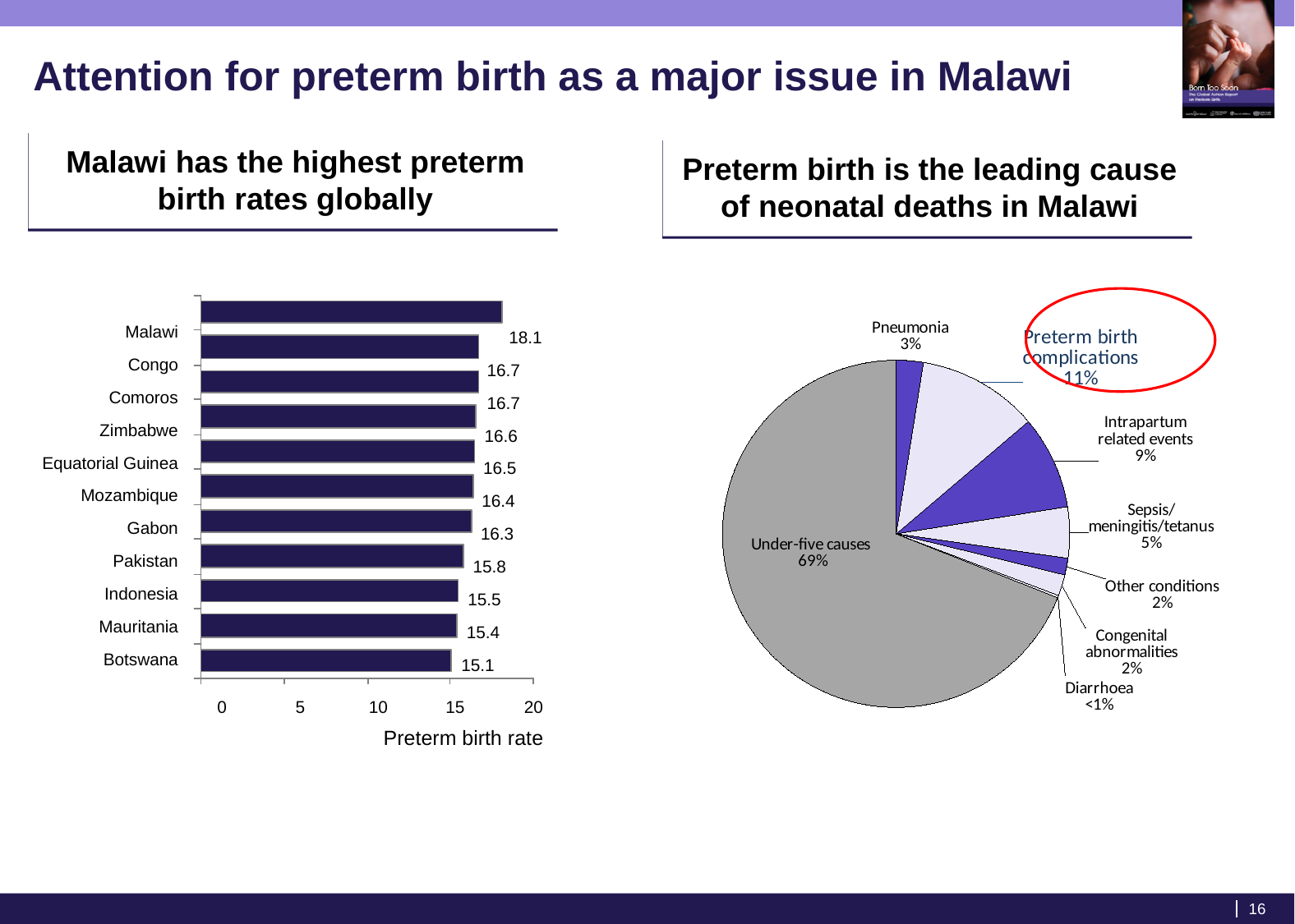
How many slices does the pie chart on the right have? 8 In the bar chart on the left, which has the higher preterm birth rate, Pakistan or Indonesia? Pakistan In the bar chart on the left, which country has the highest preterm birth rate? Malawi In the pie chart on the right, what share of neonatal deaths is attributed to preterm birth complications? 11% In the pie chart on the right, which category has the largest share? Under-five causes In the bar chart on the left, what is the difference between the preterm birth rates of Malawi and Botswana? 3.0 In the bar chart on the left, which country has the lowest preterm birth rate? Botswana In the bar chart on the left, what is the preterm birth rate for Malawi? 18.1 What type of chart is used on the left side of the slide to show preterm birth rates? Bar chart What is the x-axis title of the bar chart on the left? Preterm birth rate How many countries are shown in the bar chart on the left? 11 In the bar chart on the left, what is the preterm birth rate for Botswana? 15.1